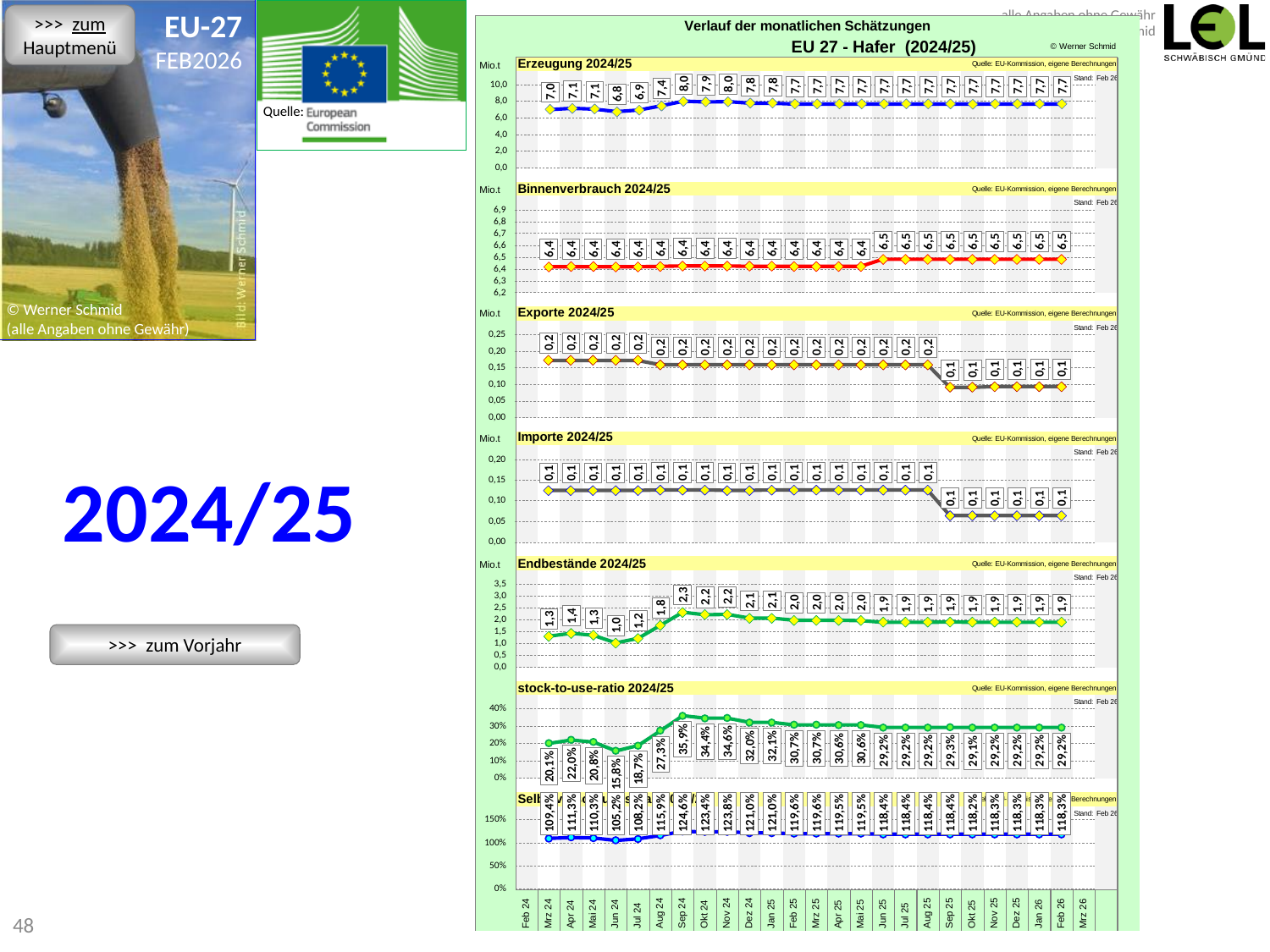
What kind of chart is the 'Erzeugung 2024/25' chart? line chart In the 'stock-to-use-ratio 2024/25' chart, is the value for Feb 26 greater or less than 20%? greater In the 'Exporte 2024/25' chart, what is the value for Mrz 24? 0,2 In the 'Binnenverbrauch 2024/25' chart, what is the value for Feb 26? 6,5 In the 'stock-to-use-ratio 2024/25' chart, which month has the lowest value? Jun 24 In the 'Endbestände 2024/25' chart, what is the value for Jun 24? 1,0 In the 'Erzeugung 2024/25' chart, what is the value for Feb 26? 7,7 In the 'Endbestände 2024/25' chart, which month has the highest value? Sep 24 In the 'stock-to-use-ratio 2024/25' chart, what is the value for Sep 24? 35,9% In the 'Endbestände 2024/25' chart, what is the difference between the Sep 24 value and the Jun 24 value? 1,3 In the 'Erzeugung 2024/25' chart, what is the value for Sep 24? 8,0 In the 'Erzeugung 2024/25' chart, which month has the lowest value? Jun 24